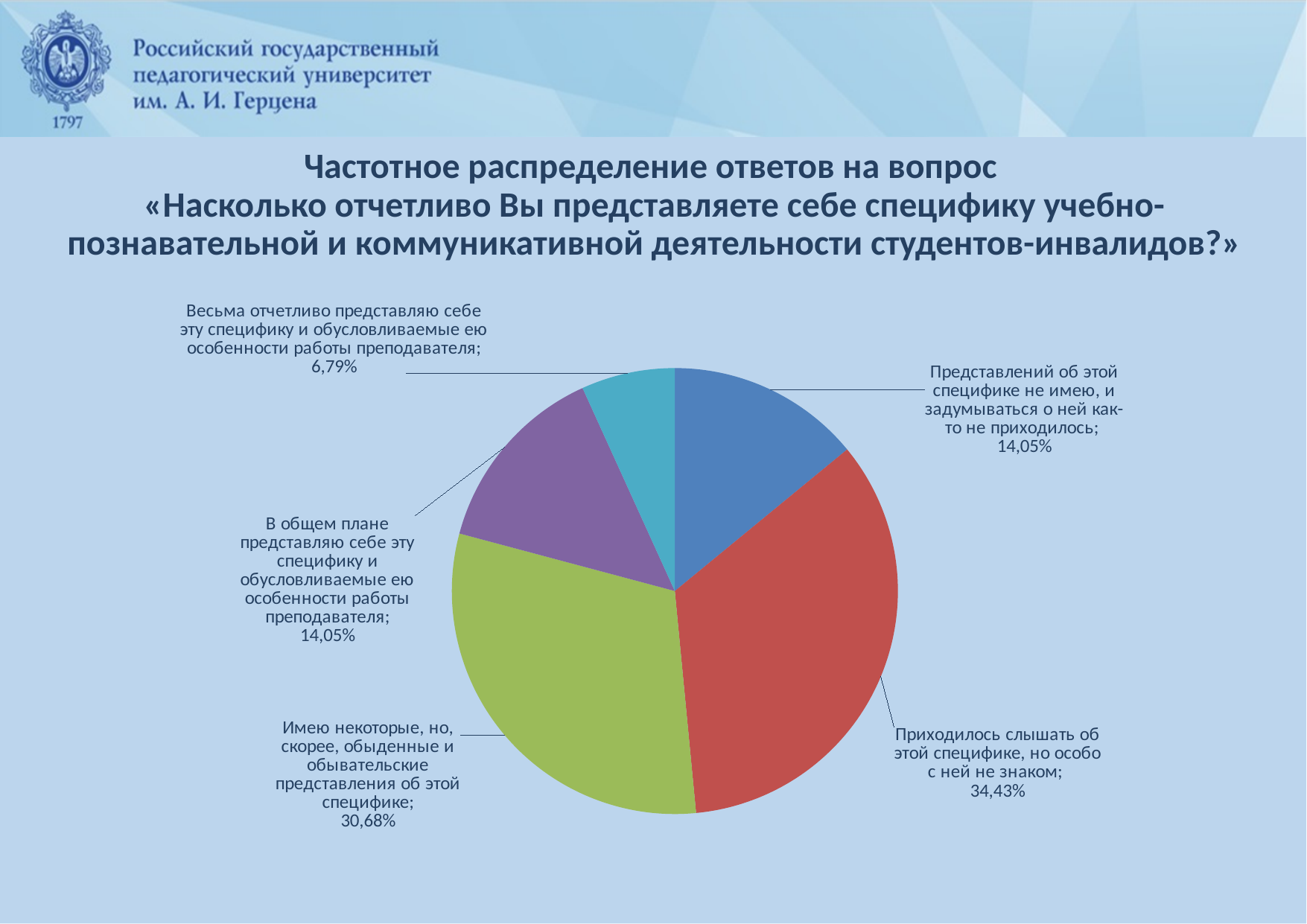
What share is shown for «Представлений об этой специфике не имею, и задумываться о ней как-то не приходилось»? 14,05% How many slices does the pie chart have? 5 Which answer option has the smallest share of the pie? Весьма отчетливо представляю себе эту специфику и обусловливаемые ею особенности работы преподавателя What is the difference between the largest slice (34,43%) and the smallest slice (6,79%)? 27,64% Which answer option has the largest share of the pie? Приходилось слышать об этой специфике, но особо с ней не знаком What share of respondents answered «Приходилось слышать об этой специфике, но особо с ней не знаком»? 34,43% What percentage is shown for «Весьма отчетливо представляю себе эту специфику и обусловливаемые ею особенности работы преподавателя»? 6,79% What percentage is shown for «Имею некоторые, но, скорее, обыденные и обывательские представления об этой специфике»? 30,68% What kind of chart is shown on the slide? Pie chart Which is larger: the share for «Имею некоторые, но, скорее, обыденные и обывательские представления об этой специфике» or for «В общем плане представляю себе эту специфику и обусловливаемые ею особенности работы преподавателя»? Имею некоторые, но, скорее, обыденные и обывательские представления об этой специфике What colour is the largest slice of the pie chart? Red What is the difference in percentage points between «Приходилось слышать об этой специфике, но особо с ней не знаком» and «Имею некоторые, но, скорее, обыденные и обывательские представления об этой специфике»? 3,75%